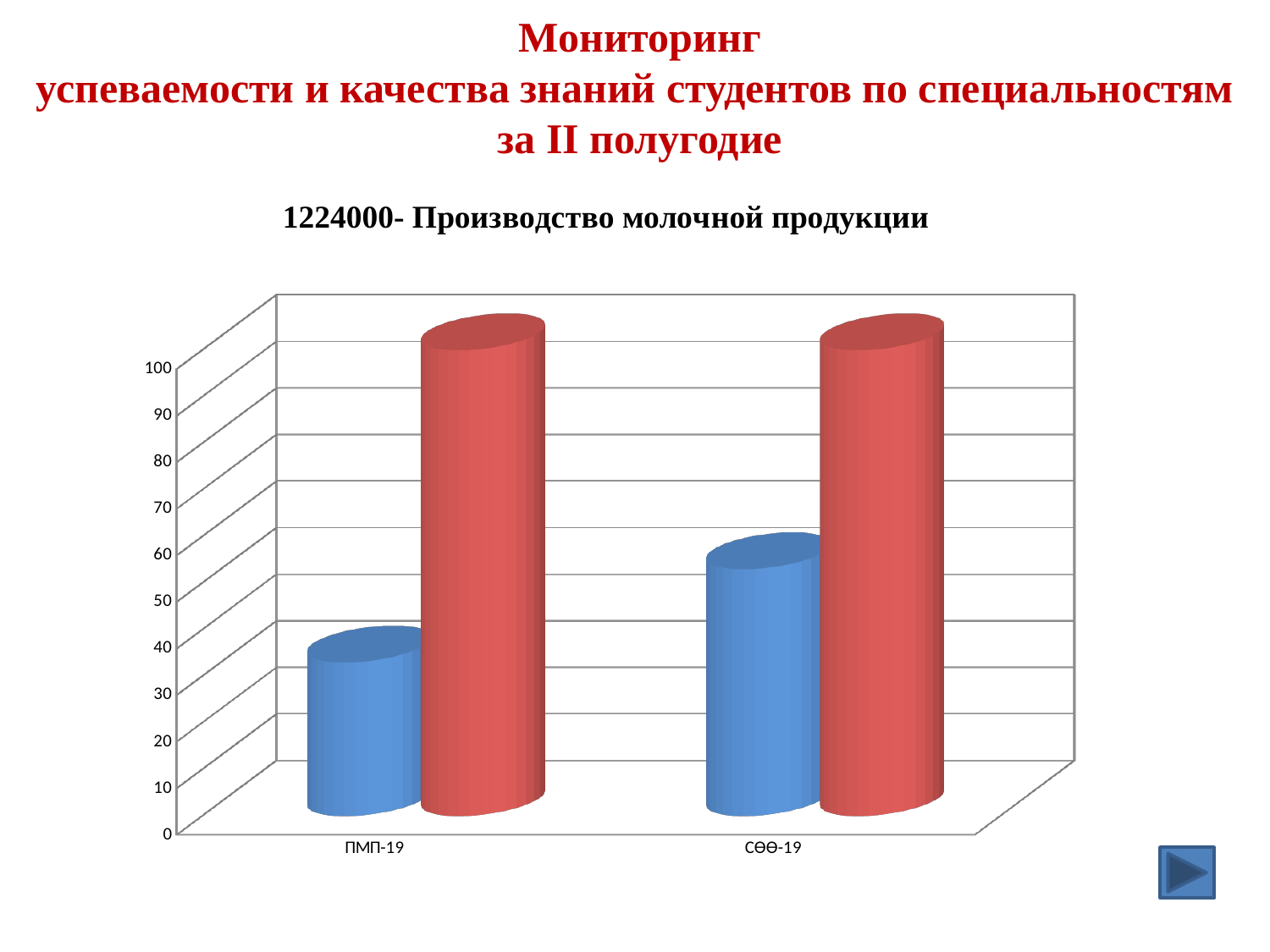
Is the value of the blue bar for СӨӨ-19 greater or less than 70? less Is the value of the red bar for СӨӨ-19 greater or less than 80? greater What kind of chart is shown on the slide? bar chart What two colours are used for the bars in the chart? blue and red For ПМП-19, which bar is taller, the blue one or the red one? the red one Is the value of the blue bar for СӨӨ-19 greater or less than 40? greater What is the title of the chart? 1224000- Производство молочной продукции How many categories are shown on the x axis of the chart? 2 Which category has the larger blue bar, ПМП-19 or СӨӨ-19? СӨӨ-19